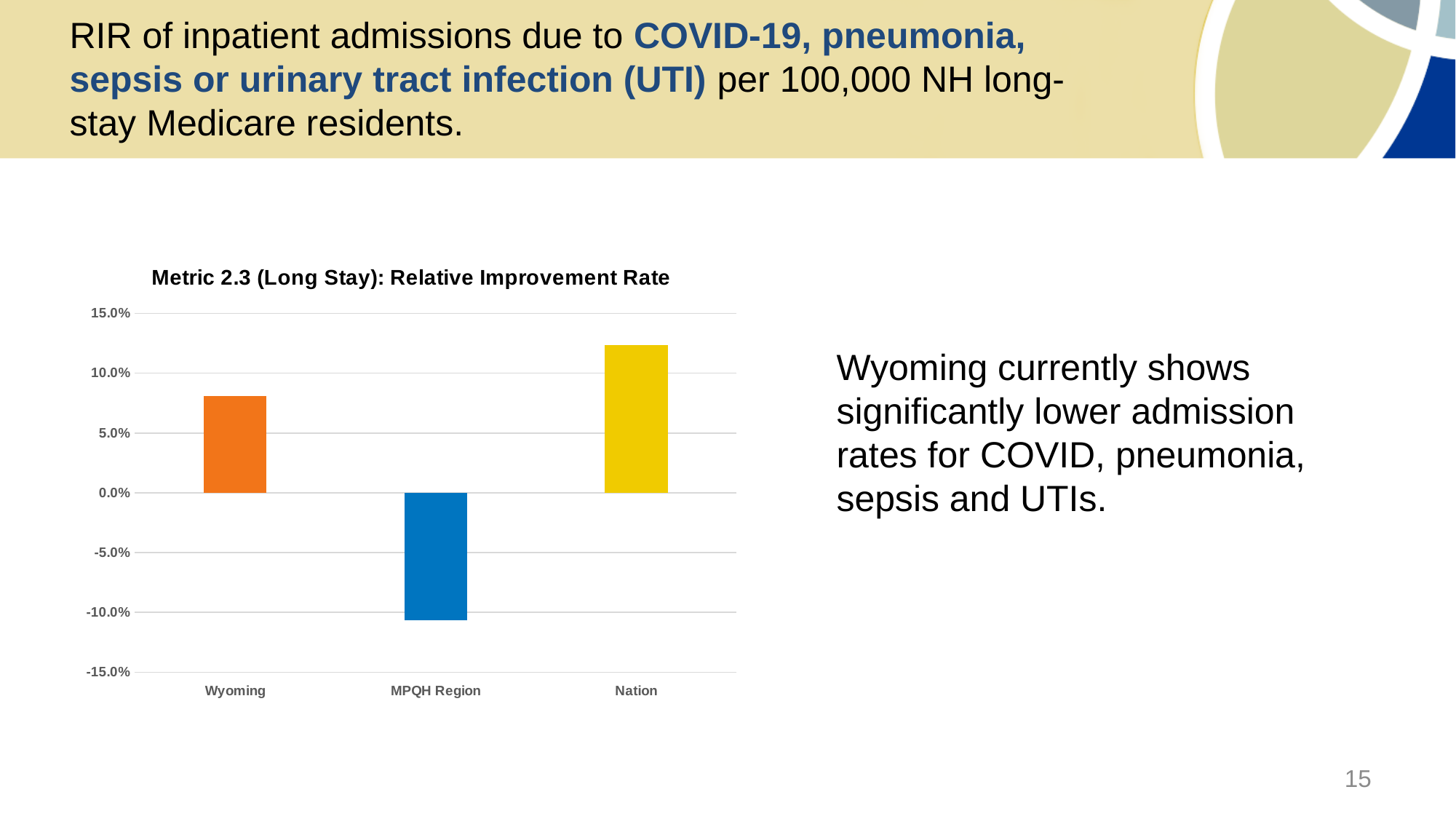
What colour is the bar for Wyoming? orange Is the value for Wyoming greater or less than 5.0%? greater Which category has the highest relative improvement rate? Nation Which is larger, the value for Wyoming or the value for MPQH Region? Wyoming Is the value for MPQH Region greater or less than -5.0%? less What kind of chart is shown on the slide? bar chart How many categories are plotted on the chart? 3 Is the value for Wyoming greater or less than 10.0%? less Which category has the lowest relative improvement rate? MPQH Region What is the title of the chart? Metric 2.3 (Long Stay): Relative Improvement Rate Which is larger, the value for Wyoming or the value for Nation? Nation